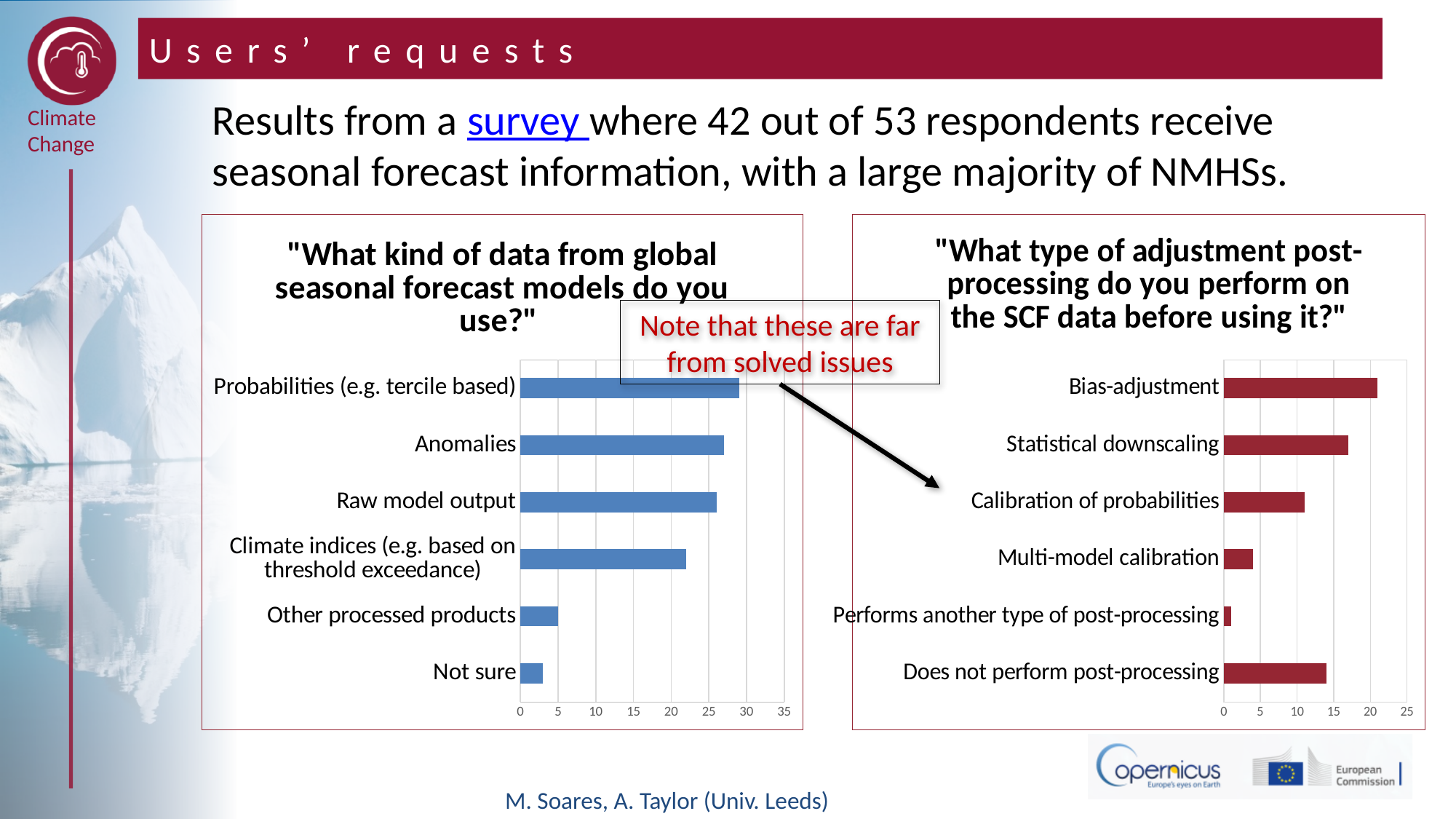
In the left chart, "What kind of data from global seasonal forecast models do you use?", how many categories are shown? 6 In the left chart, "What kind of data from global seasonal forecast models do you use?", which category has the highest value? Probabilities (e.g. tercile based) In the right chart, "What type of adjustment post-processing do you perform on the SCF data before using it?", which category has the highest value? Bias-adjustment In the left chart, "What kind of data from global seasonal forecast models do you use?", is the value for Climate indices (e.g. based on threshold exceedance) greater or less than 20? greater In the left chart, "What kind of data from global seasonal forecast models do you use?", which category has the lowest value? Not sure In the right chart, "What type of adjustment post-processing do you perform on the SCF data before using it?", which is larger: Does not perform post-processing or Multi-model calibration? Does not perform post-processing In the left chart, "What kind of data from global seasonal forecast models do you use?", which is larger: Raw model output or Climate indices (e.g. based on threshold exceedance)? Raw model output In the right chart, "What type of adjustment post-processing do you perform on the SCF data before using it?", how many categories are shown? 6 In the right chart, "What type of adjustment post-processing do you perform on the SCF data before using it?", is the value for Statistical downscaling greater or less than 15? greater What kind of chart is the left chart, "What kind of data from global seasonal forecast models do you use?"? Bar chart In the right chart, "What type of adjustment post-processing do you perform on the SCF data before using it?", which category has the lowest value? Performs another type of post-processing In the left chart, "What kind of data from global seasonal forecast models do you use?", is the value for Other processed products greater or less than 10? less